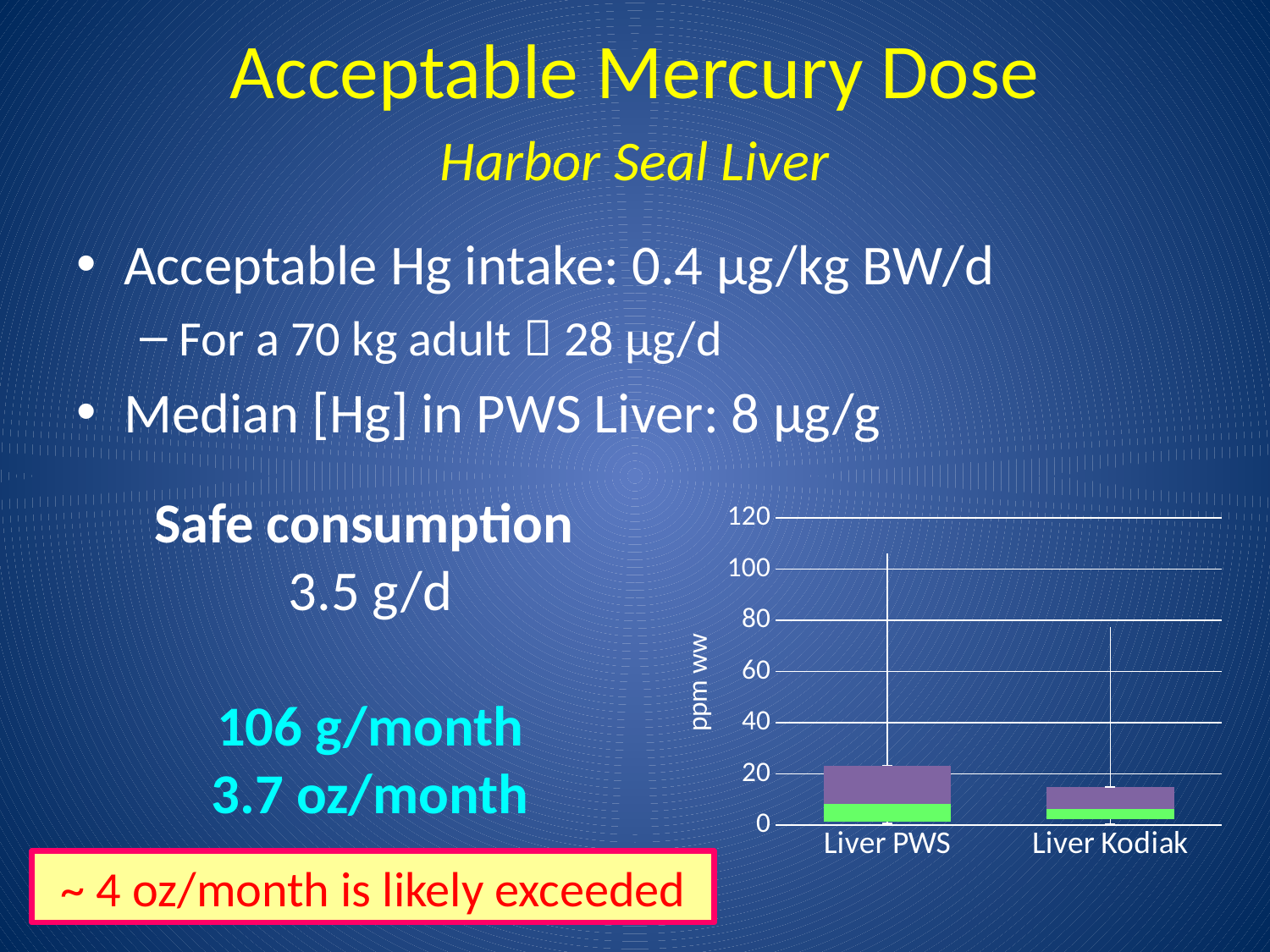
Which category has the higher upper whisker in the chart, Liver PWS or Liver Kodiak? Liver PWS Is the top of the upper whisker for Liver PWS greater or less than 100? greater What are the two categories on the x axis of the chart? Liver PWS and Liver Kodiak Is the top of the upper whisker for Liver Kodiak greater or less than 100? less What is the highest tick value shown on the y axis of the chart? 120 Which category has the taller box in the chart? Liver PWS What is the label on the y axis of the chart? ppm ww Is the top of the box for Liver PWS greater or less than 40? less How many categories are shown on the x axis of the chart? 2 Which category has the shorter box in the chart? Liver Kodiak